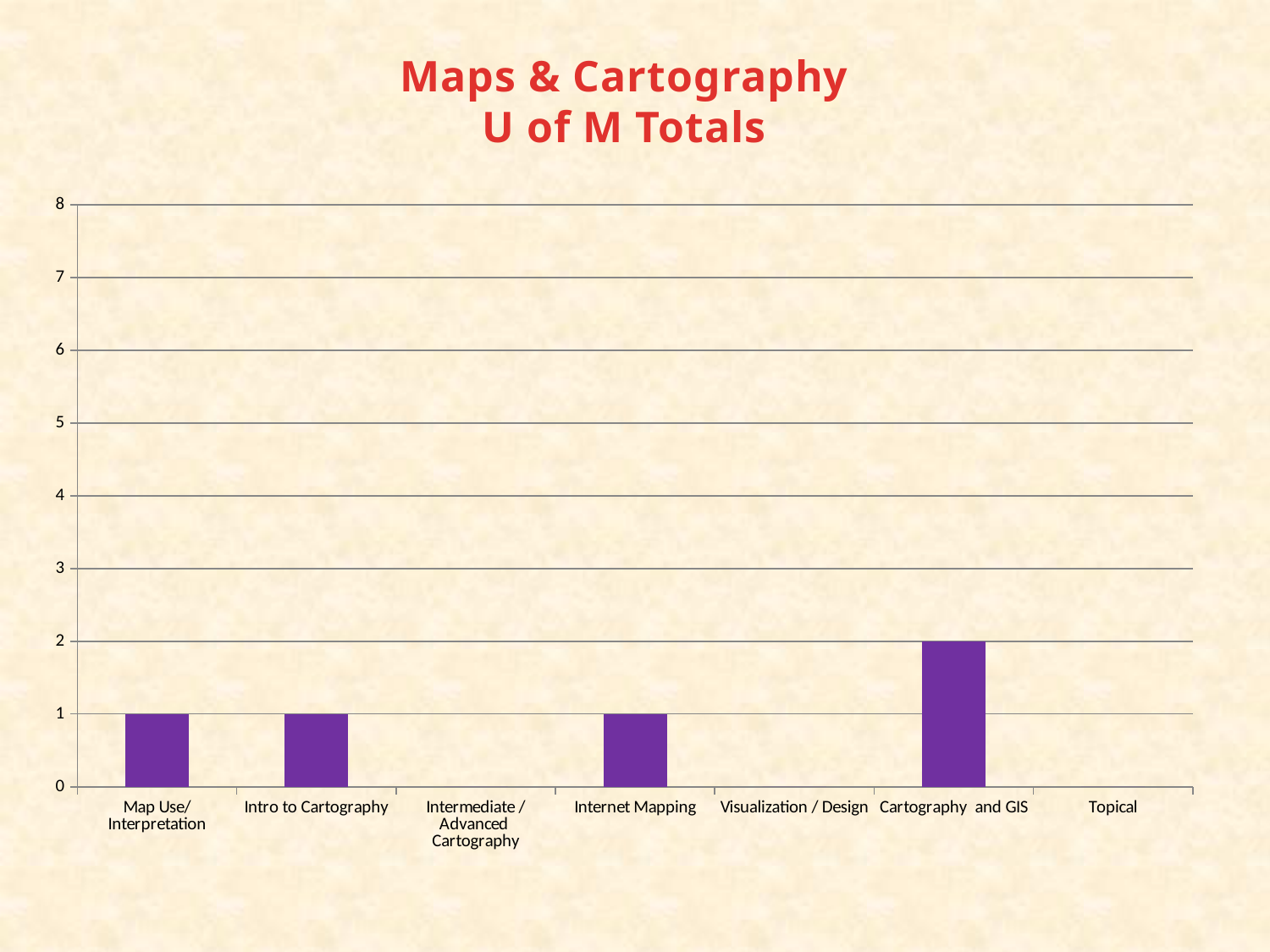
What colour are the bars in the chart? purple What is the difference between the values for Cartography and GIS and Internet Mapping? 1 Is the value for Cartography and GIS greater or less than 5? less What is the value for Intro to Cartography? 1 Which category has the highest value? Cartography and GIS How many categories are shown on the x axis? 7 What is the value for Cartography and GIS? 2 What type of chart is shown on the slide? bar chart What is the value for Map Use/Interpretation? 1 What is the value for Internet Mapping? 1 What is the title of the chart? Maps & Cartography U of M Totals Which is larger, the value for Cartography and GIS or the value for Intro to Cartography? Cartography and GIS